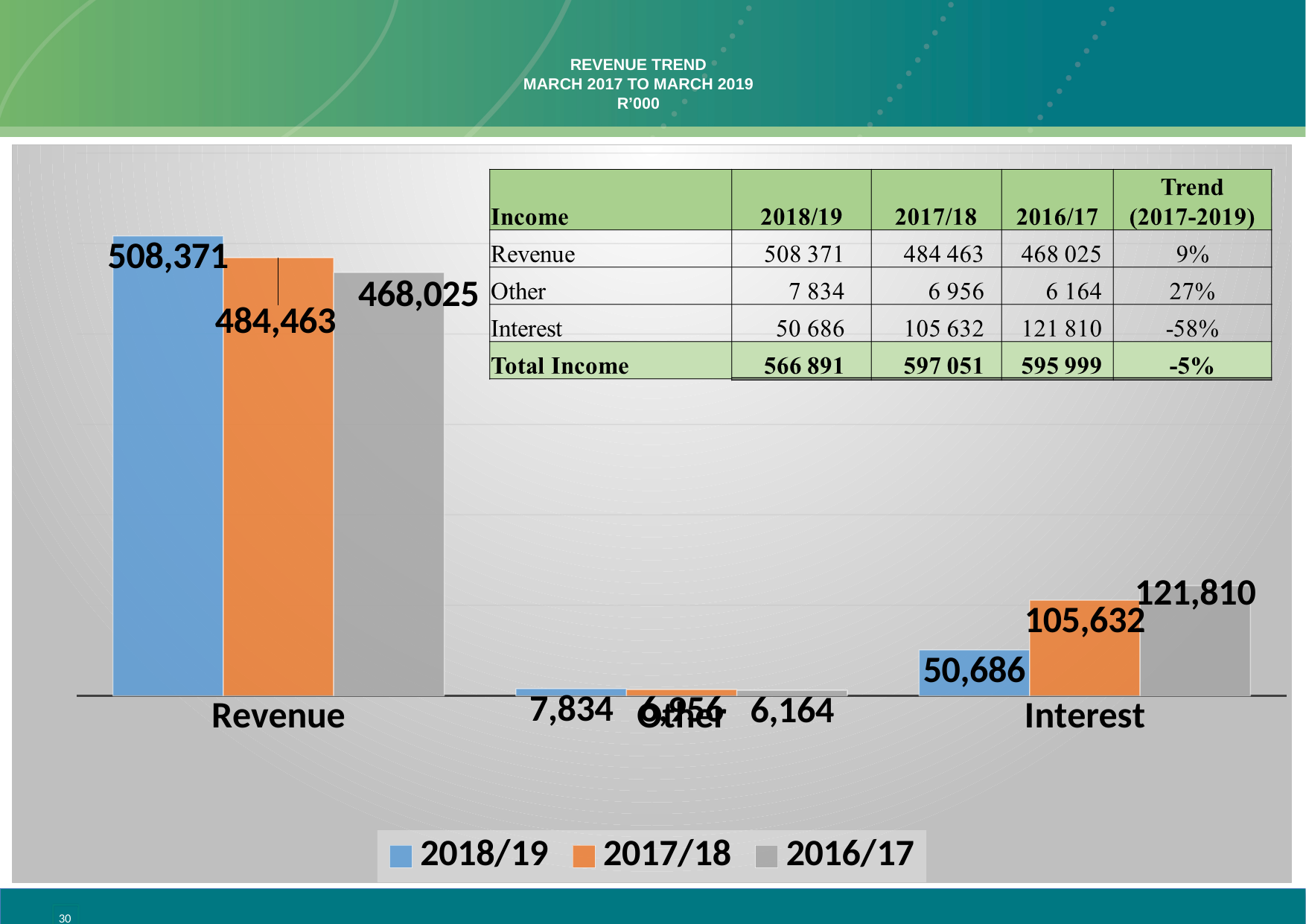
Which series is shown in orange in the chart legend? 2017/18 What type of chart is shown on the slide? bar chart How many categories are shown on the x axis of the chart? 3 Which series has the highest value for Interest? 2016/17 What is the value for Revenue in the 2016/17 series? 468,025 What is the value for Interest in the 2017/18 series? 105,632 What is the value for Other in the 2018/19 series? 7,834 What is the difference between the 2018/19 and 2017/18 values for Revenue? 23,908 How many series does the chart legend list? 3 Which category has the lowest values across all series? Other What is the value for Revenue in the 2018/19 series? 508,371 Which is larger for Interest: the 2018/19 value or the 2016/17 value? 2016/17